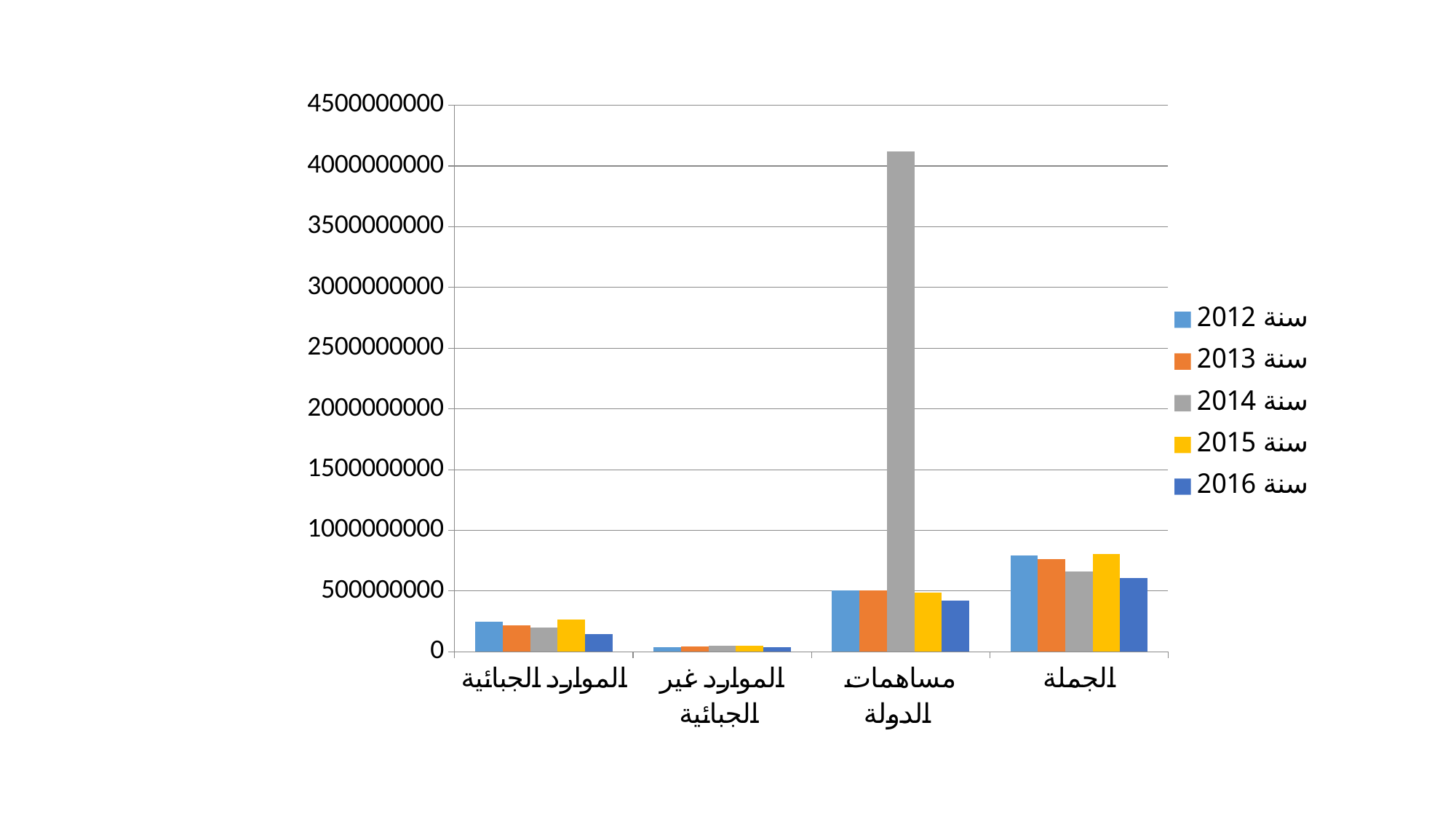
How many series does the legend list? 5 Which series has the lowest bar in the الموارد الجبائية category? سنة 2016 Which series has the lowest bar in the الجملة category? سنة 2016 What kind of chart is shown on the slide? bar chart How many categories are shown on the x axis? 4 Which is larger: the سنة 2014 value for مساهمات الدولة or the سنة 2014 value for الجملة? مساهمات الدولة Is the value for سنة 2014 in مساهمات الدولة greater or less than 4000000000? greater Is the value for سنة 2012 in الجملة greater or less than 1000000000? less Is the value for سنة 2015 in الموارد الجبائية greater or less than 500000000? less Which is larger: the سنة 2016 value for الجملة or the سنة 2016 value for الموارد غير الجبائية? الجملة What colour represents the سنة 2014 series in the legend? gray Which series has the highest bar in the مساهمات الدولة category? سنة 2014